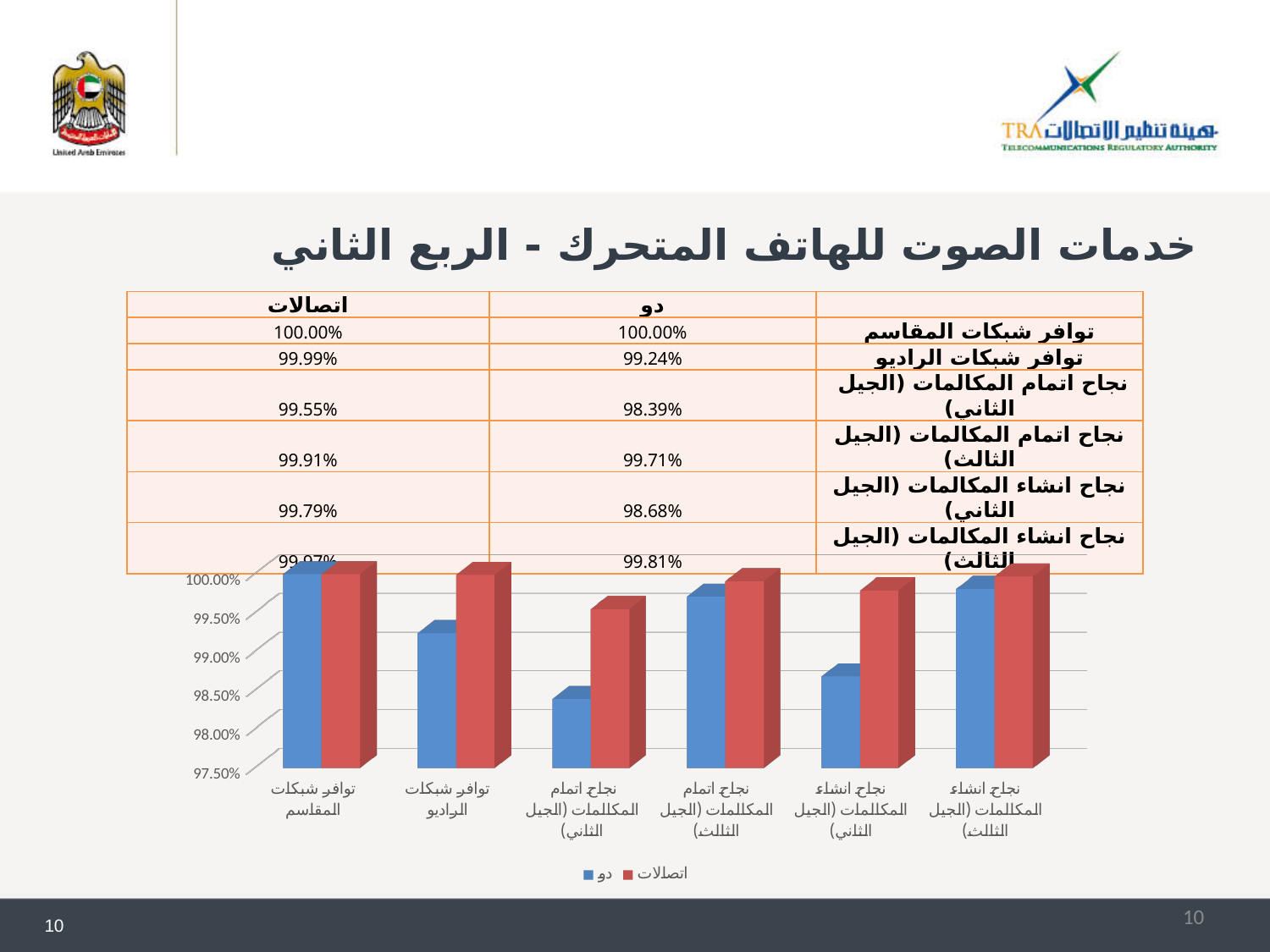
What kind of chart is shown on the slide? bar chart How many series does the chart legend list? 2 What is the value for دو (du) in the category نجاح انشاء المكالمات (الجيل الثاني)? 98.68% Which category has the lowest value for دو (du)? نجاح اتمام المكالمات (الجيل الثاني) How many categories are plotted along the x axis of the chart? 6 Which series has the larger value in the category توافر شبكات الراديو, اتصالات or دو? اتصالات Is the value for دو (du) in the category نجاح انشاء المكالمات (الجيل الثاني) greater or less than 99.00%? less What is the title of the slide containing the chart? خدمات الصوت للهاتف المتحرك - الربع الثاني What is the value for دو (du) in the category نجاح اتمام المكالمات (الجيل الثاني)? 98.39% What is the value for اتصالات (Etisalat) in the category توافر شبكات الراديو? 99.99% What is the difference between the اتصالات and دو values in the category نجاح اتمام المكالمات (الجيل الثالث)? 0.20% Which colour represents the series دو in the chart? blue